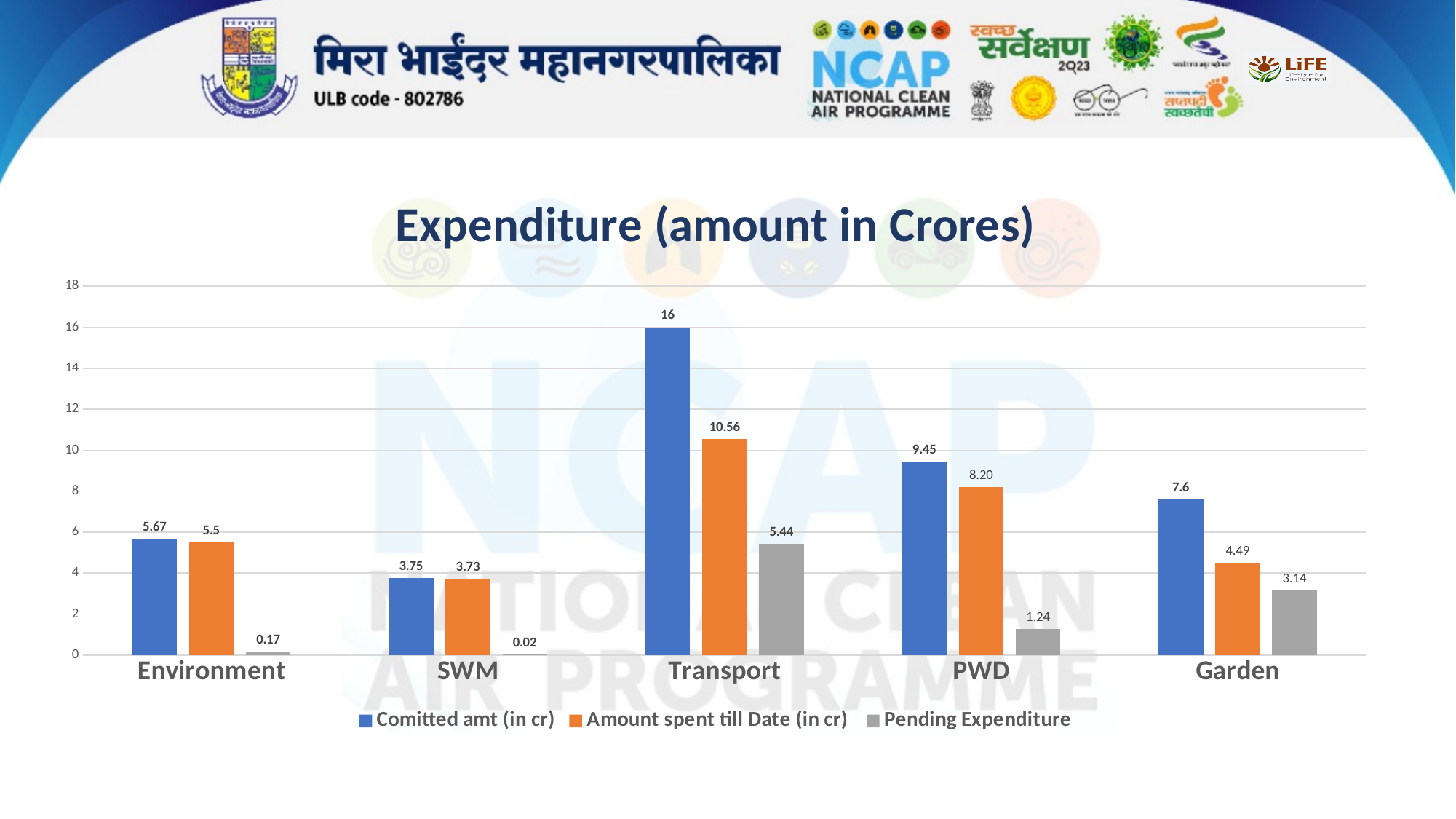
What is the committed amount (in cr) for Transport? 16 What is the amount spent till date (in cr) for PWD? 8.20 Which category has the highest committed amount? Transport Which category has the lowest pending expenditure? SWM What is the pending expenditure for Garden? 3.14 What kind of chart is shown on the slide? Bar chart What is the amount spent till date (in cr) for Environment? 5.5 How many series does the legend list? 3 How many categories are shown on the x axis? 5 Which has a larger committed amount, PWD or Garden? PWD What is the difference between the committed amount and the amount spent till date for Transport? 5.44 What is the title of the chart? Expenditure (amount in Crores)